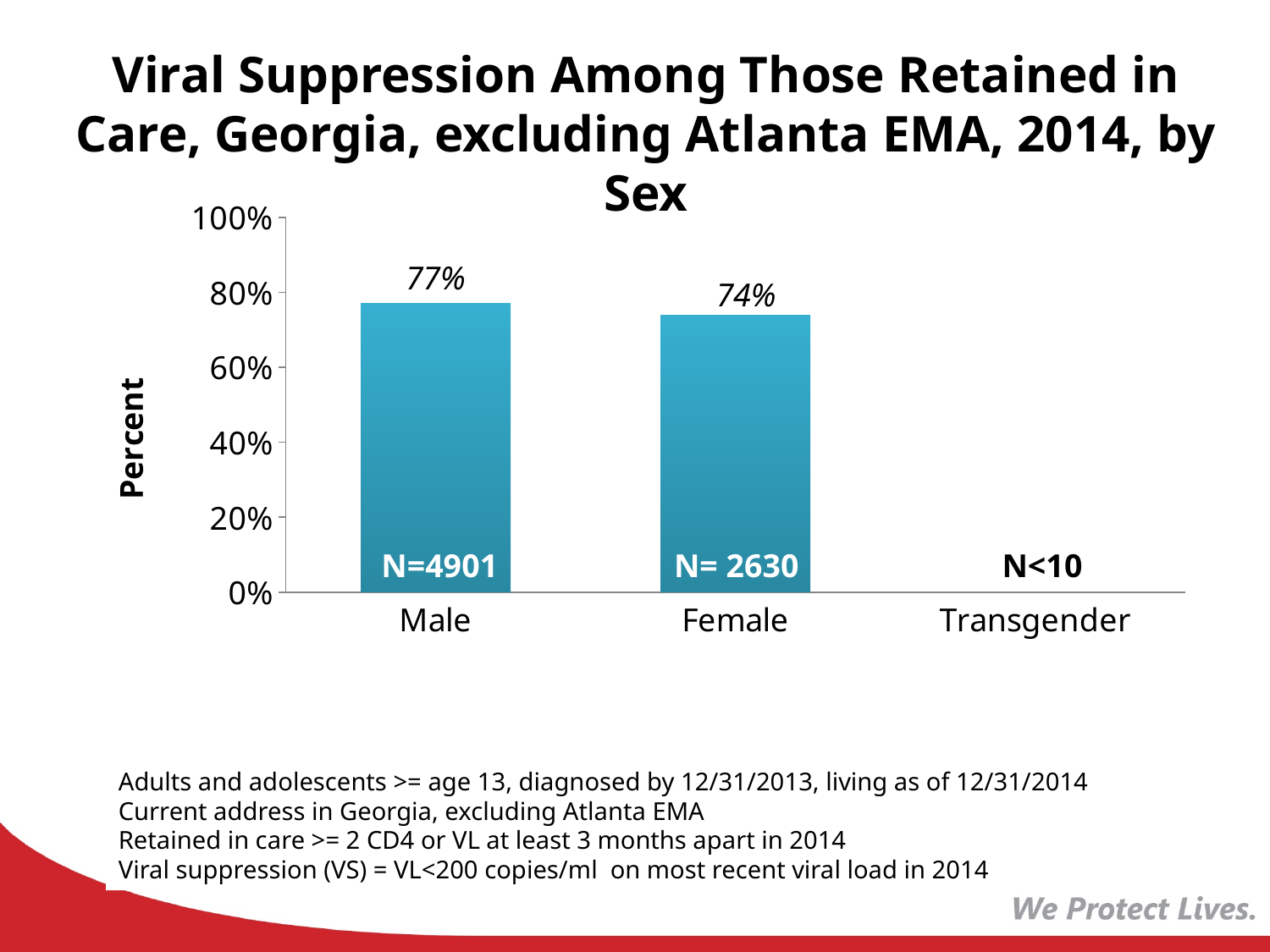
What is the N shown for the Male bar? N=4901 What is the viral suppression percentage for Male? 77% What is the viral suppression percentage for Female? 74% How many sex categories are shown on the x axis? 3 Is the value for Female greater or less than 80%? less What is the difference in viral suppression percentage between Male and Female? 3% What kind of chart is shown on the slide? bar chart Is the value for Male greater or less than 60%? greater What is the N shown for the Female bar? N= 2630 Which has a higher viral suppression percentage, Male or Female? Male Which sex category has the highest viral suppression percentage shown? Male What is the label of the y axis? Percent